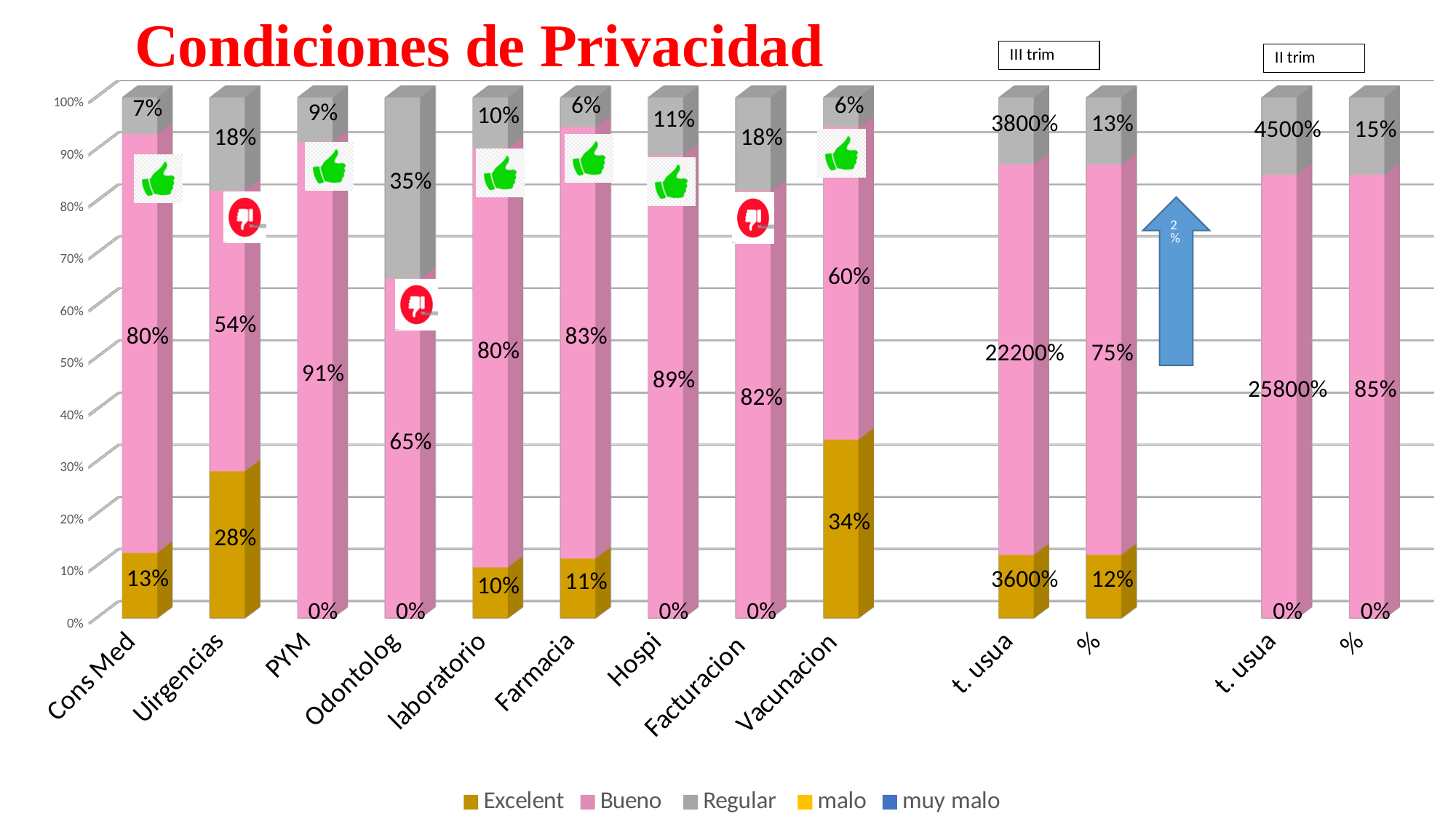
How many series does the legend list? 5 Which is larger, the Excelent value for Cons Med or for laboratorio? Cons Med What is the title of the chart? Condiciones de Privacidad How many categories are shown on the x axis? 13 What is the Excelent value for Uirgencias? 28% What kind of chart is shown on the slide? Stacked bar chart What is the Excelent value for Vacunacion? 34% What is the Regular value for Odontolog? 35% What is the Bueno value for PYM? 91% What is the difference between the Bueno values for Hospi and Facturacion? 7% Among the service categories from Cons Med to Vacunacion, which has the lowest Bueno value? Uirgencias